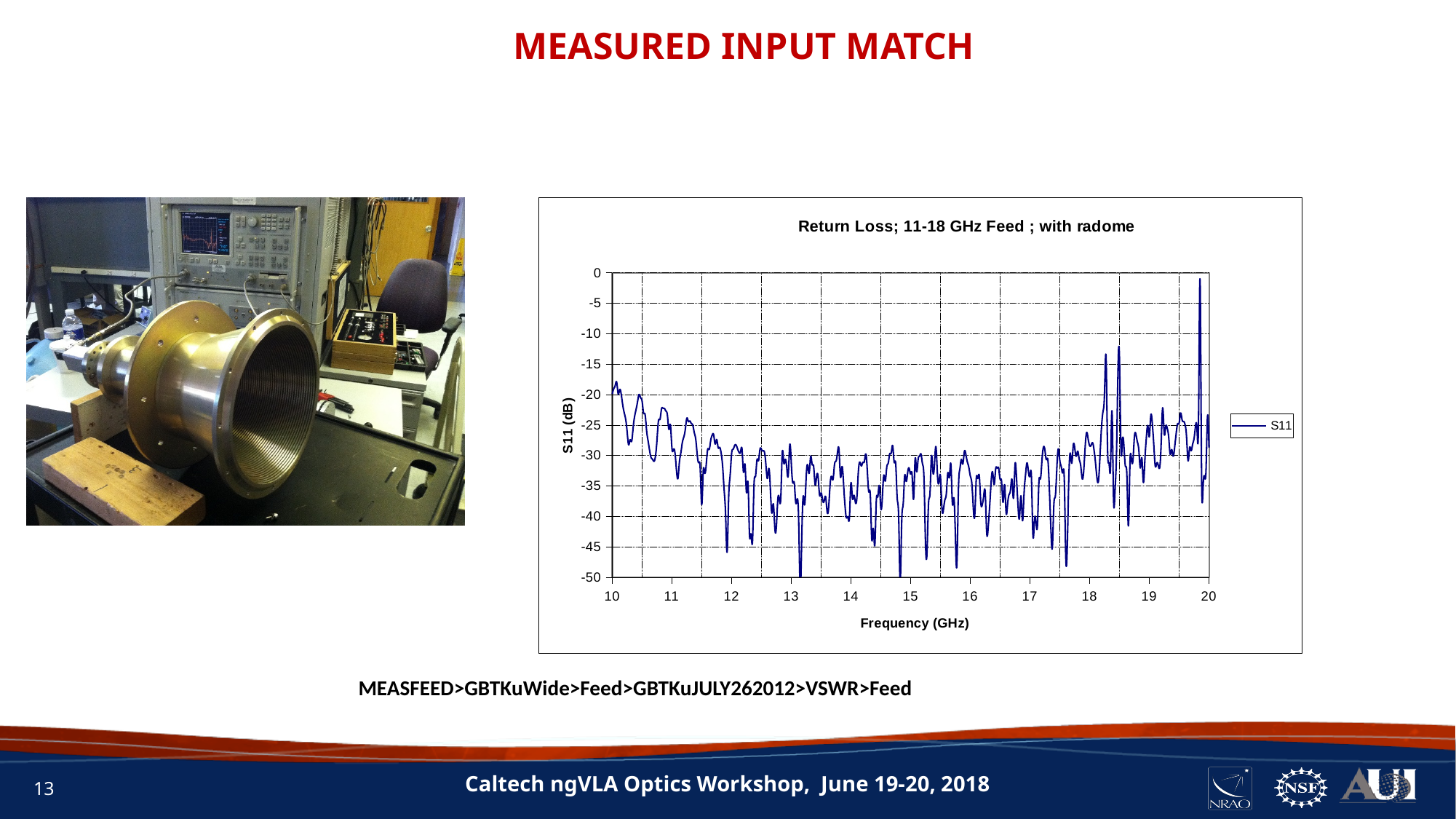
Is the S11 value at 10 GHz greater or less than -25? greater What is the label of the x axis? Frequency (GHz) What is the title of the chart? Return Loss; 11-18 GHz Feed ; with radome What is the lowest value shown on the y axis? -50 What kind of chart is shown on the slide? line chart Is the highest peak of the S11 trace, near 19.8 GHz, greater or less than -5? greater How many series does the chart's legend list? 1 What is the highest frequency shown on the x axis? 20 Between 10 GHz and 13 GHz, does the S11 trace generally rise or fall? fall Is the S11 value at the deep dip near 14.8 GHz greater or less than -45? less What is the label of the y axis? S11 (dB) What is the name of the series shown in the legend? S11